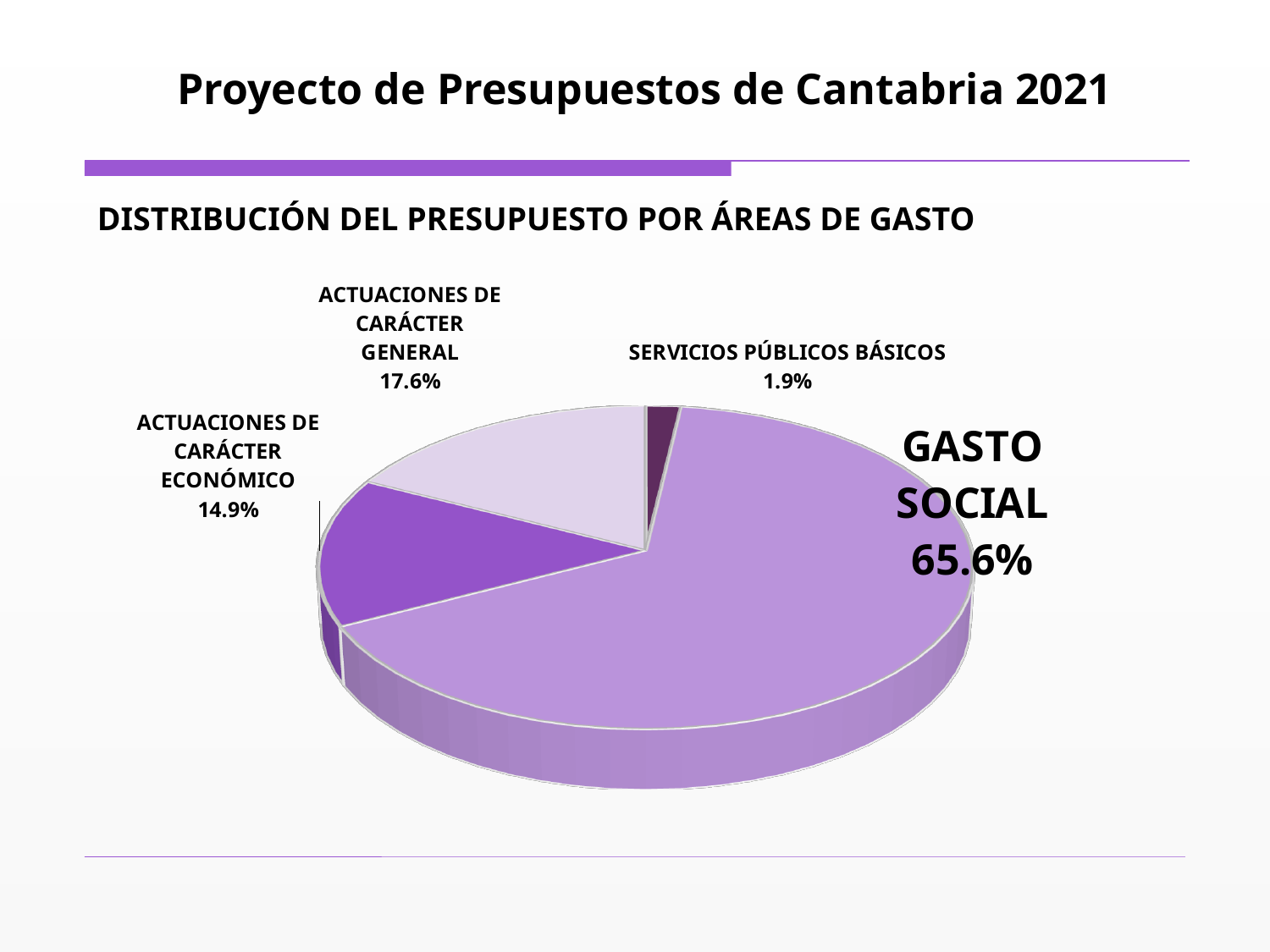
How many areas of spending are shown in the pie chart? 4 What percentage is shown for ACTUACIONES DE CARÁCTER GENERAL? 17.6% Which area of spending has the largest share of the budget? GASTO SOCIAL Which is larger, the share for ACTUACIONES DE CARÁCTER GENERAL or for ACTUACIONES DE CARÁCTER ECONÓMICO? ACTUACIONES DE CARÁCTER GENERAL What is the title of the chart? DISTRIBUCIÓN DEL PRESUPUESTO POR ÁREAS DE GASTO What share of the budget goes to GASTO SOCIAL? 65.6% What is the difference in percentage points between ACTUACIONES DE CARÁCTER GENERAL and ACTUACIONES DE CARÁCTER ECONÓMICO? 2.7 What percentage is shown for SERVICIOS PÚBLICOS BÁSICOS? 1.9% What percentage is shown for ACTUACIONES DE CARÁCTER ECONÓMICO? 14.9% What is the difference in percentage points between GASTO SOCIAL and ACTUACIONES DE CARÁCTER GENERAL? 48.0 What kind of chart is shown on the slide? Pie chart Which area of spending has the smallest share of the budget? SERVICIOS PÚBLICOS BÁSICOS